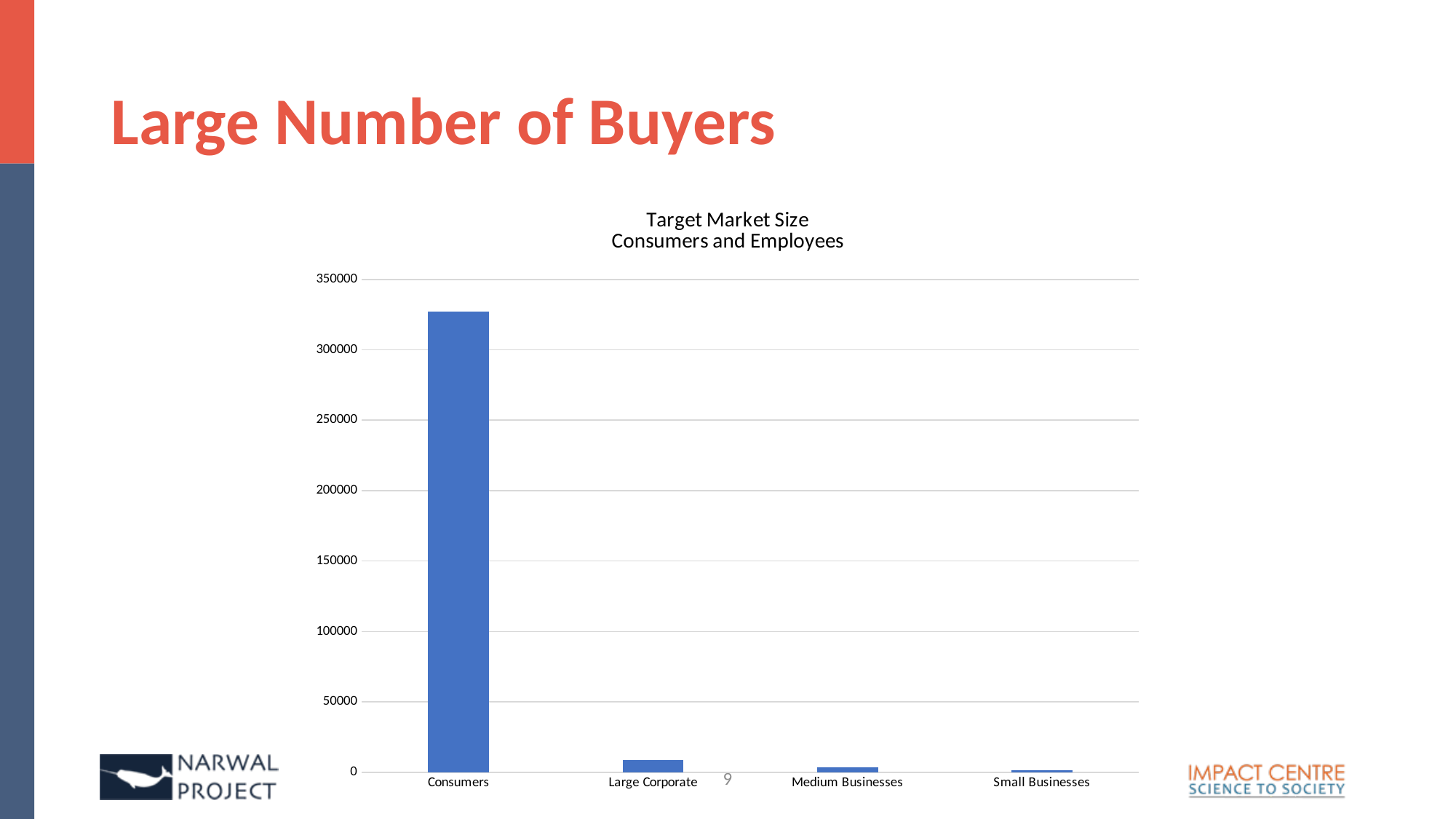
How many categories are shown on the x axis of the chart? 4 Which category is the third from the left on the x axis? Medium Businesses Which is larger, the value for Large Corporate or the value for Small Businesses? Large Corporate What is the highest value shown on the y axis of the chart? 350000 Is the value for Consumers greater or less than 300000? greater Which is larger, the value for Consumers or the value for Large Corporate? Consumers Which category has the highest value in the chart? Consumers What kind of chart is shown on the slide? bar chart Is the value for Medium Businesses greater or less than 50000? less Is the value for Large Corporate greater or less than 50000? less What is the title of the chart? Target Market Size Consumers and Employees